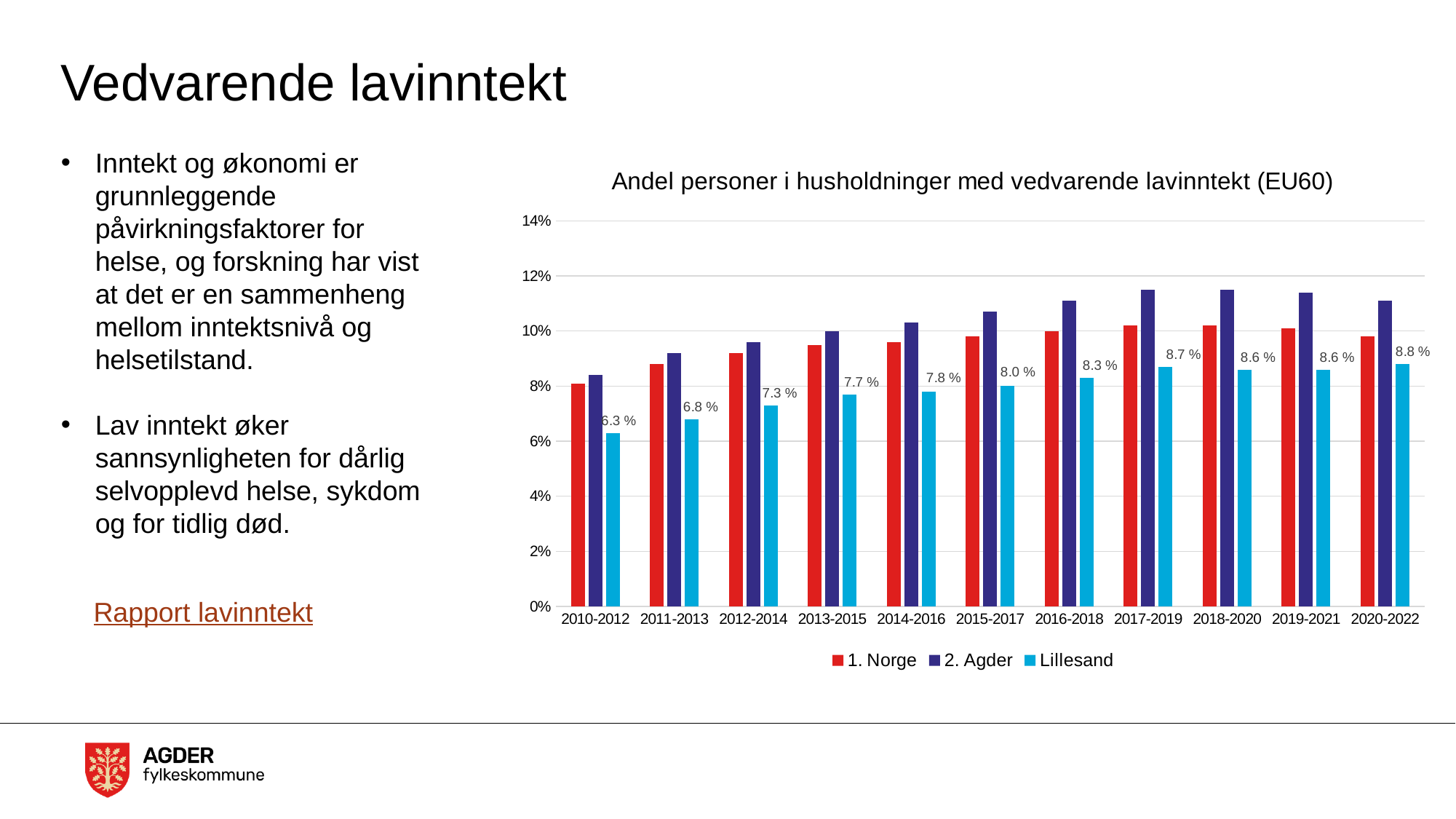
Is the value for 2. Agder in 2017-2019 greater or less than 10%? greater In 2017-2019, which is larger: the value for 1. Norge or for 2. Agder? 2. Agder In which period is the Lillesand value highest? 2020-2022 In which period is the Lillesand value lowest? 2010-2012 What is the value for Lillesand in 2010-2012? 6.3 % Is the value for 1. Norge in 2010-2012 greater or less than 10%? less How many series does the legend list? 3 How many periods are shown on the x axis? 11 What is the value for Lillesand in 2015-2017? 8.0 % What is the value for Lillesand in 2020-2022? 8.8 % What kind of chart is shown on the slide? Bar chart What is the difference between the Lillesand values for 2020-2022 and 2010-2012? 2.5 percentage points